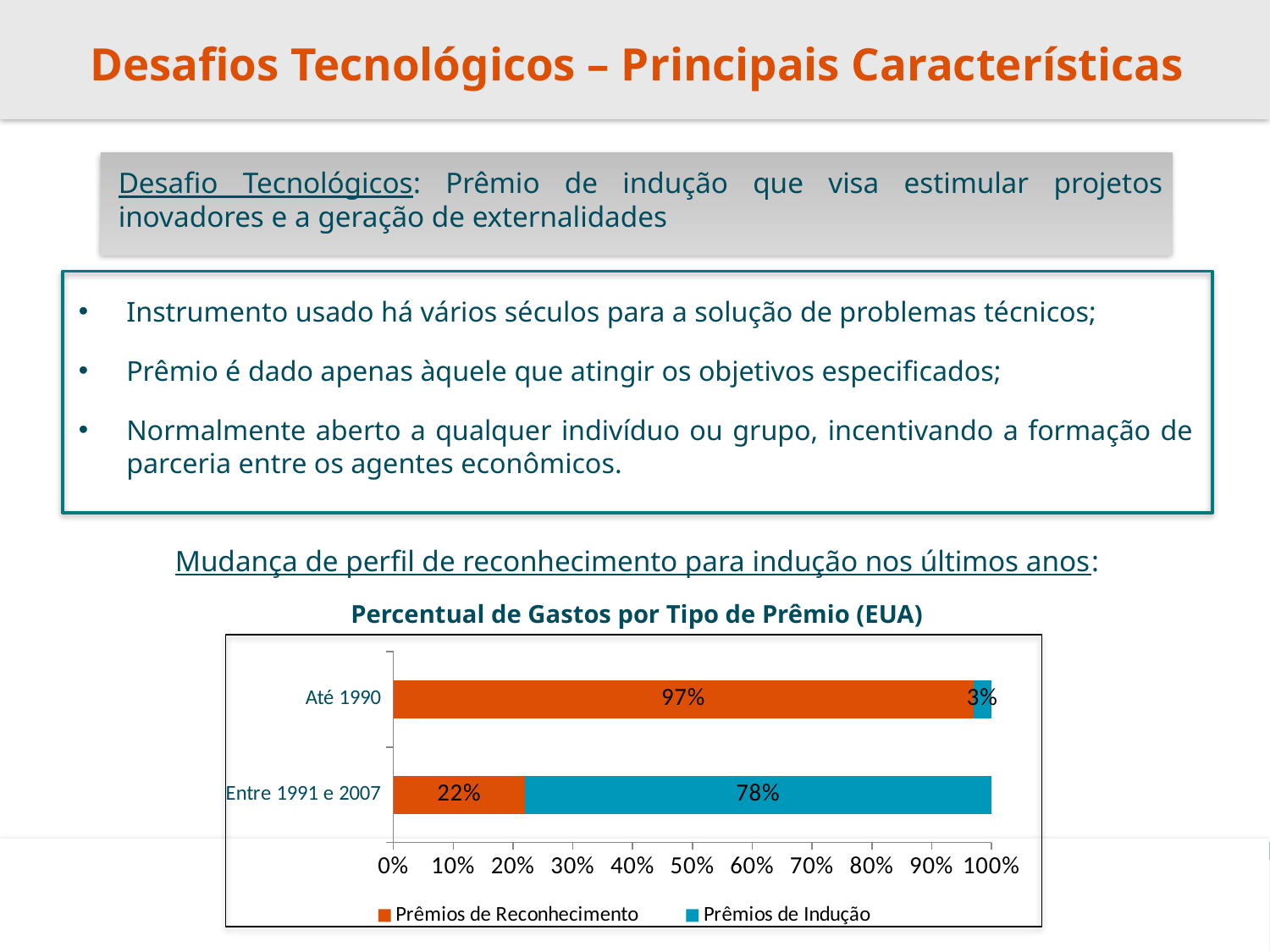
What is the value for Prêmios de Reconhecimento in the Entre 1991 e 2007 bar? 22% What kind of chart is shown on the slide? Stacked bar chart What is the difference between Prêmios de Indução in Entre 1991 e 2007 and in Até 1990? 75% What is the value for Prêmios de Reconhecimento in the Até 1990 bar? 97% What is the title of the chart? Percentual de Gastos por Tipo de Prêmio (EUA) Which period has the lower value for Prêmios de Reconhecimento? Entre 1991 e 2007 What is the value for Prêmios de Indução in the Até 1990 bar? 3% Which period has the higher value for Prêmios de Indução? Entre 1991 e 2007 How many periods (categories) are shown on the chart? 2 In the Entre 1991 e 2007 bar, which is larger: Prêmios de Reconhecimento or Prêmios de Indução? Prêmios de Indução How many series does the legend list? 2 What is the value for Prêmios de Indução in the Entre 1991 e 2007 bar? 78%